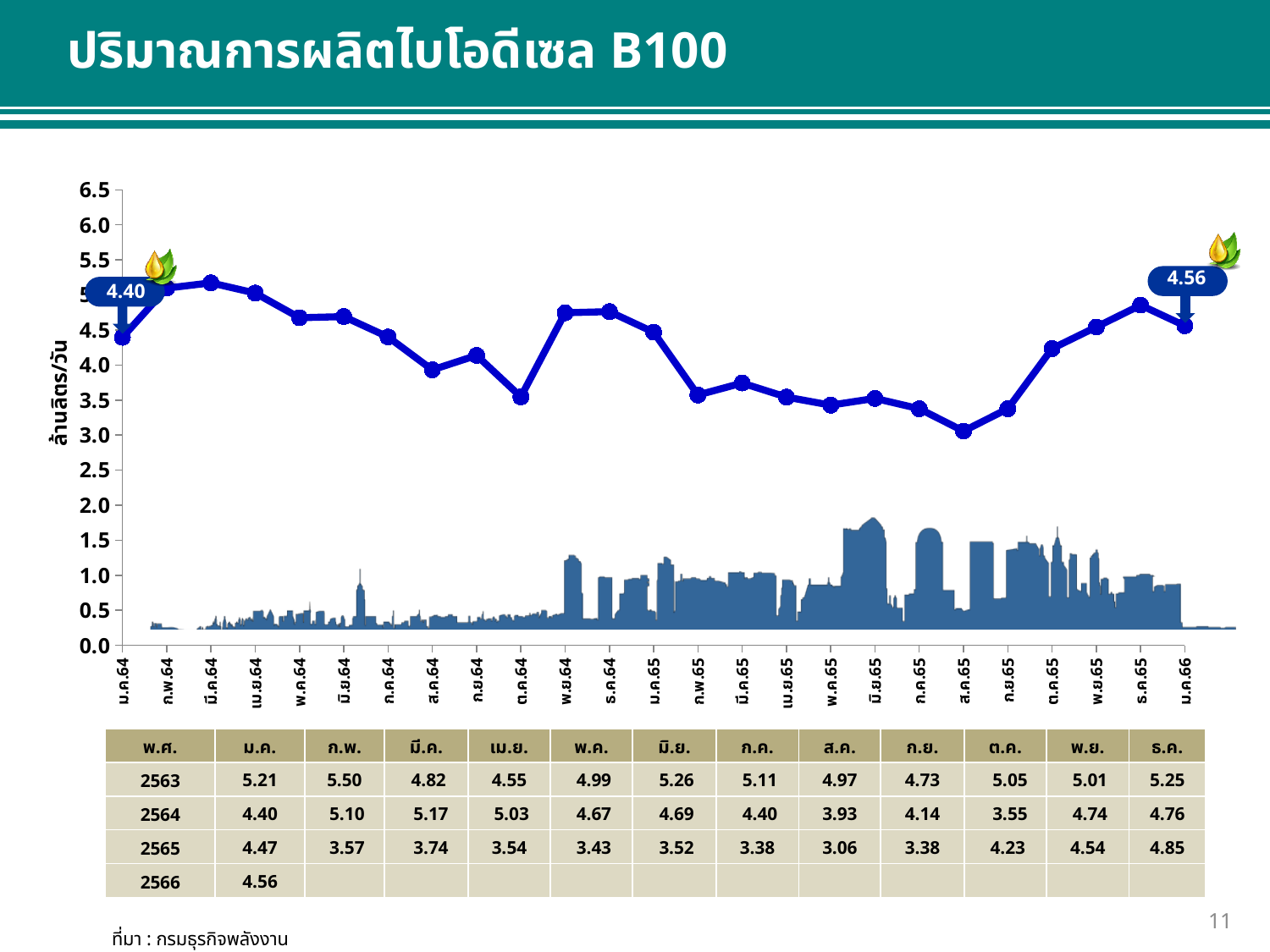
Which is larger, the value for ม.ค.66 or the value for ม.ค.64? ม.ค.66 Do the values rise or fall from ส.ค.65 to ธ.ค.65? rise Is the value for ส.ค.65 greater or less than 3.5? less What is the label on the vertical axis of the chart? ล้านลิตร/วัน Is the value for พ.ย.64 greater or less than 4.5? greater Which month has the lowest value on the chart? ส.ค.65 How many monthly data points are plotted on the chart? 25 What type of chart is shown on the slide? line chart What is the labelled value for ม.ค.64 on the chart? 4.40 What is the labelled value for ม.ค.66 on the chart? 4.56 Is the value for ธ.ค.65 greater or less than 4.5? greater What is the difference between the labelled values for ม.ค.66 and ม.ค.64? 0.16